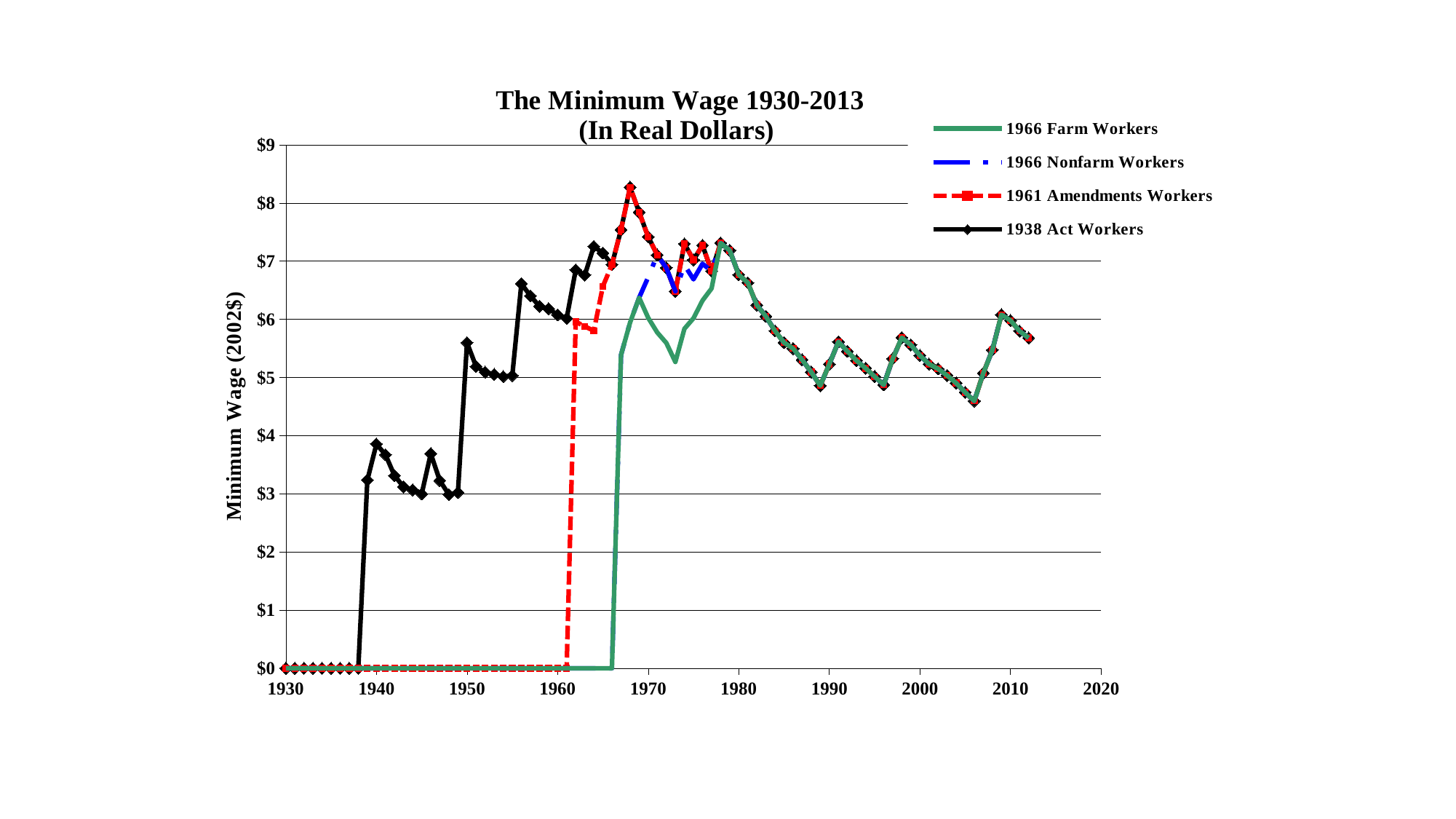
What is the label on the vertical axis? Minimum Wage (2002$) In 1970, which is higher: 1938 Act Workers or 1966 Farm Workers? 1938 Act Workers Which series has the lowest value in 1970? 1966 Farm Workers How many series does the legend list? 4 Is the value for 1966 Farm Workers in 2006 greater or less than $5? less Which series is the first to rise above $0? 1938 Act Workers Between 1980 and 1990, do the plotted values generally rise or fall? fall Is the peak value of the 1938 Act Workers line greater or less than $8? greater What kind of chart is shown on the slide? Line chart What is the title of the chart? The Minimum Wage 1930-2013 (In Real Dollars) Is the value for 1938 Act Workers in 1940 greater or less than $3? greater